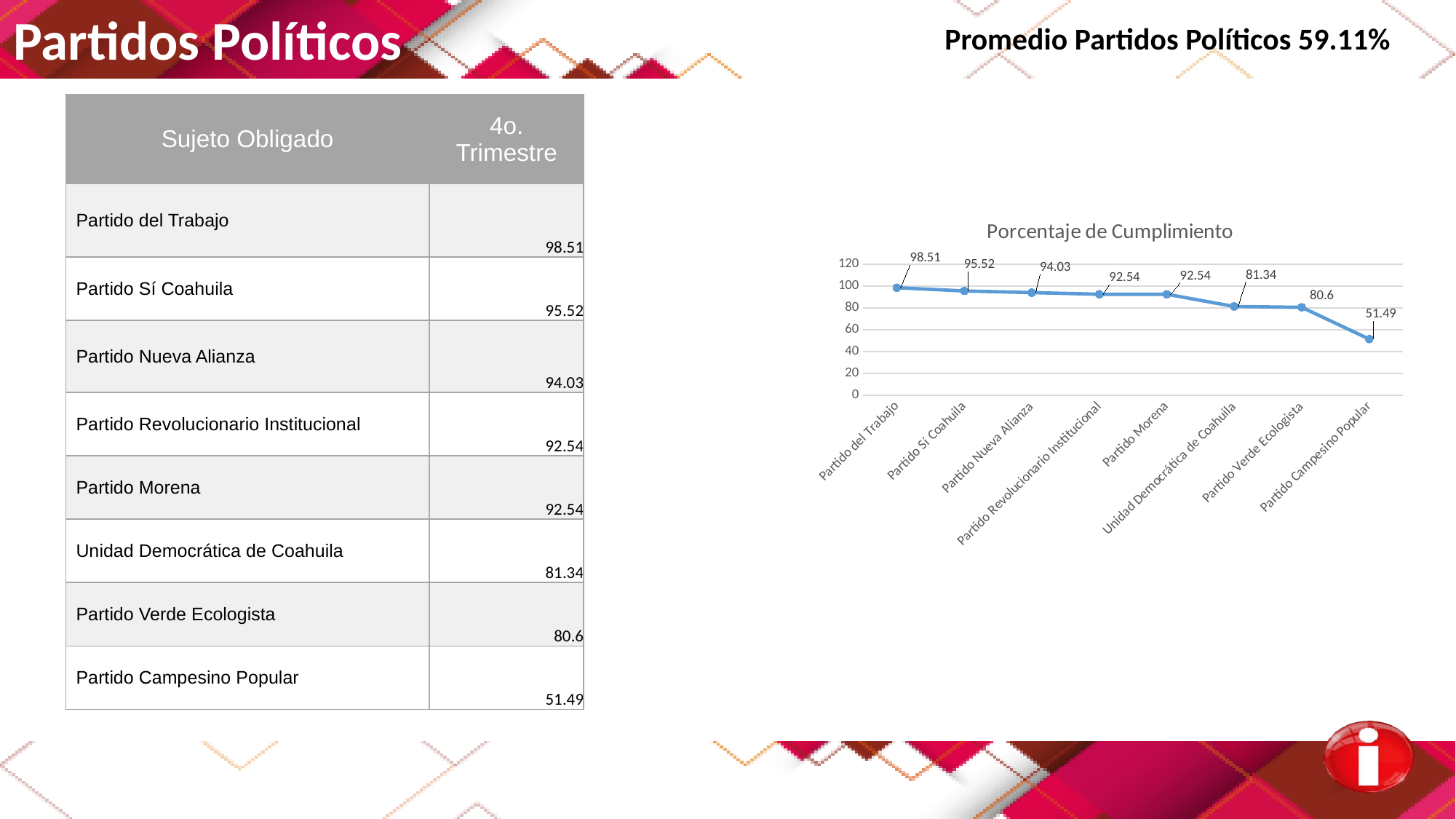
How many categories are plotted in the chart? 8 Do the values rise or fall from left to right along the x axis? fall What is the difference between the values for Partido del Trabajo and Partido Campesino Popular? 47.02 What kind of chart is shown on the slide? line chart What is the title of the chart? Porcentaje de Cumplimiento What is the value for Partido del Trabajo in the chart? 98.51 Which category has the lowest value in the chart? Partido Campesino Popular What is the value for Partido Verde Ecologista in the chart? 80.6 Which is larger, the value for Partido Sí Coahuila or the value for Partido Nueva Alianza? Partido Sí Coahuila Which category has the highest value in the chart? Partido del Trabajo What is the value for Unidad Democrática de Coahuila in the chart? 81.34 Is the value for Partido Campesino Popular greater or less than 60? less